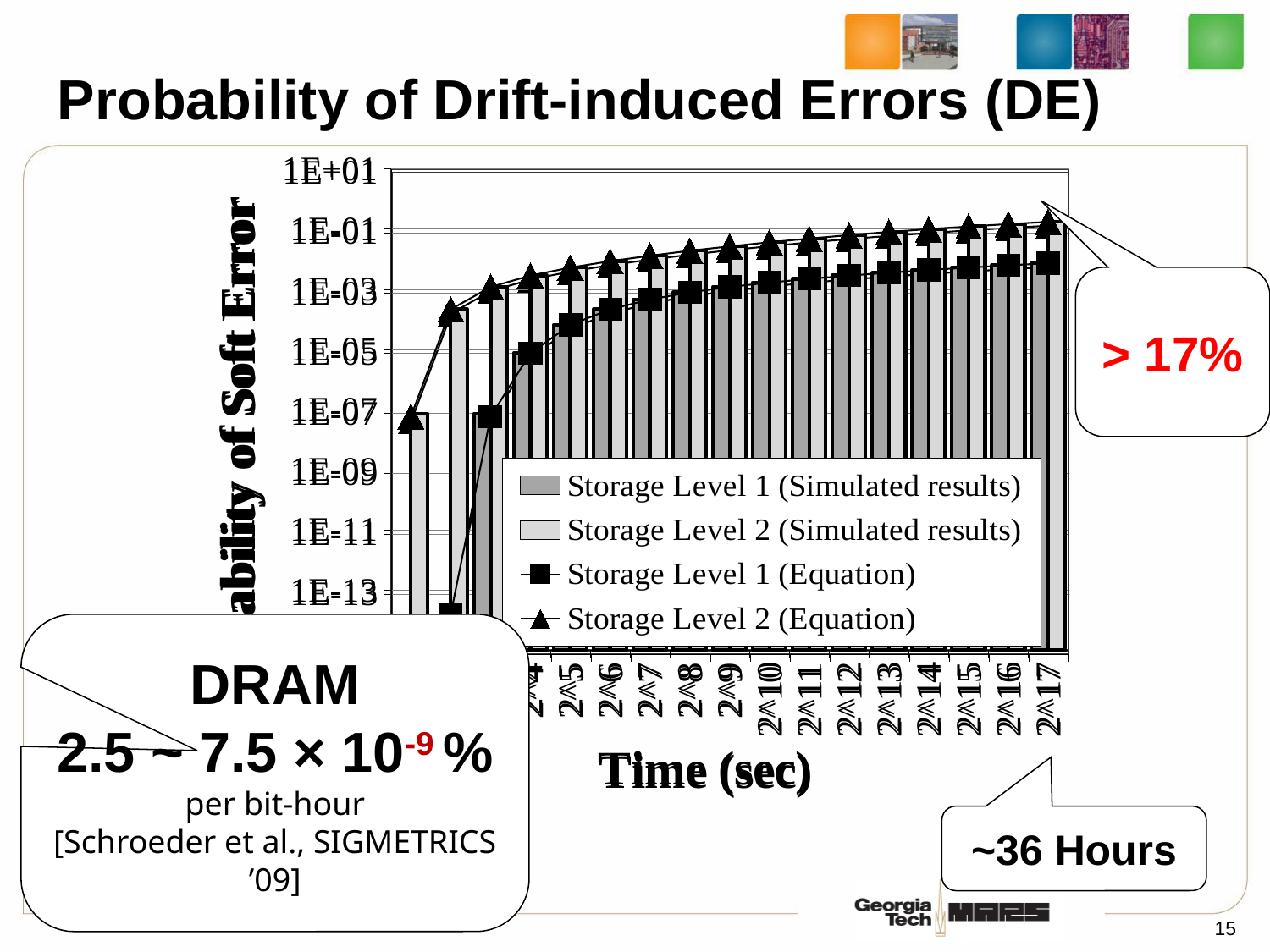
At 2^17 seconds, which is larger: the value for Storage Level 1 (Equation) or Storage Level 2 (Equation)? Storage Level 2 (Equation) Is the value for Storage Level 2 (Equation) at 2^17 seconds greater or less than 1E-03? greater What is the first legend entry of the chart? Storage Level 1 (Simulated results) What is the x-axis title of the chart? Time (sec) Is the value for Storage Level 1 (Equation) at 2^17 seconds greater or less than 1E-01? less Do the values for Storage Level 2 (Equation) rise or fall as time increases along the x axis? Rise What kind of chart is shown on the slide? Bar chart with line series What is the highest tick label shown on the y axis of the chart? 1E+01 How many series does the chart legend list? 4 Is the value for Storage Level 1 (Equation) at 2^4 seconds greater or less than 1E-03? less Do the values for Storage Level 1 (Equation) rise or fall as time increases along the x axis? Rise